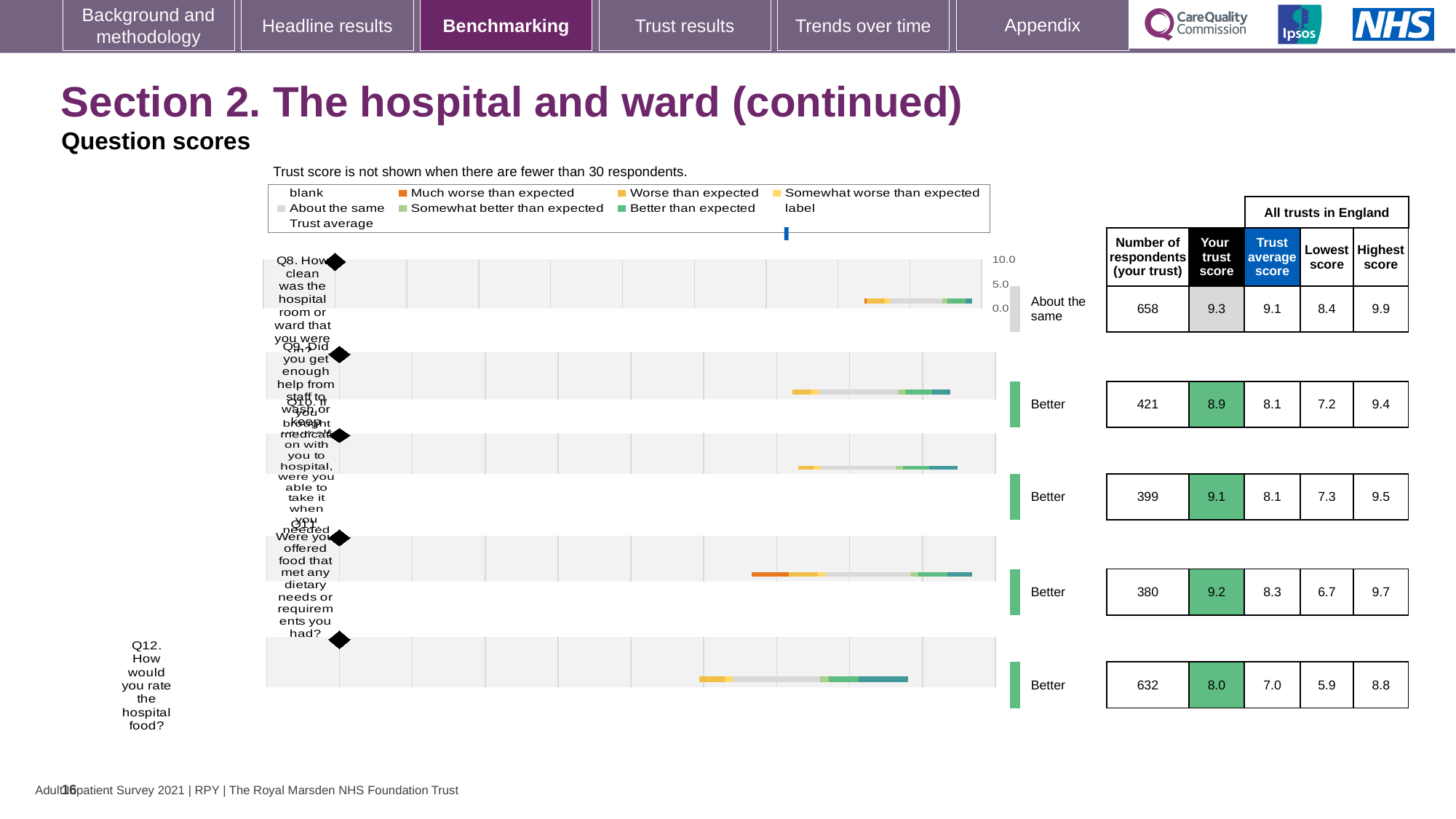
What benchmark category is shown for Q8? About the same What kind of chart is used to show the question scores on this slide? bar chart Which is larger, the trust score for Q11 or the trust score for Q10? Q11 What is the trust score for Q12 (how would you rate the hospital food)? 8.0 What is the lowest score across all trusts in England for Q11 (were you offered food that met any dietary needs)? 6.7 How many questions (Q8 to Q12) are plotted in the chart? 5 How many respondents answered Q9 (did you get enough help from staff to wash or keep yourself clean)? 421 Which question has the lowest trust score? Q12 What is the trust score for Q8 (how clean was the hospital room or ward)? 9.3 Which question has the highest trust score? Q8 What is the difference between the trust score and the trust average score for Q12? 1.0 What is the highest score across all trusts in England for Q10 (medication brought with you to hospital)? 9.5